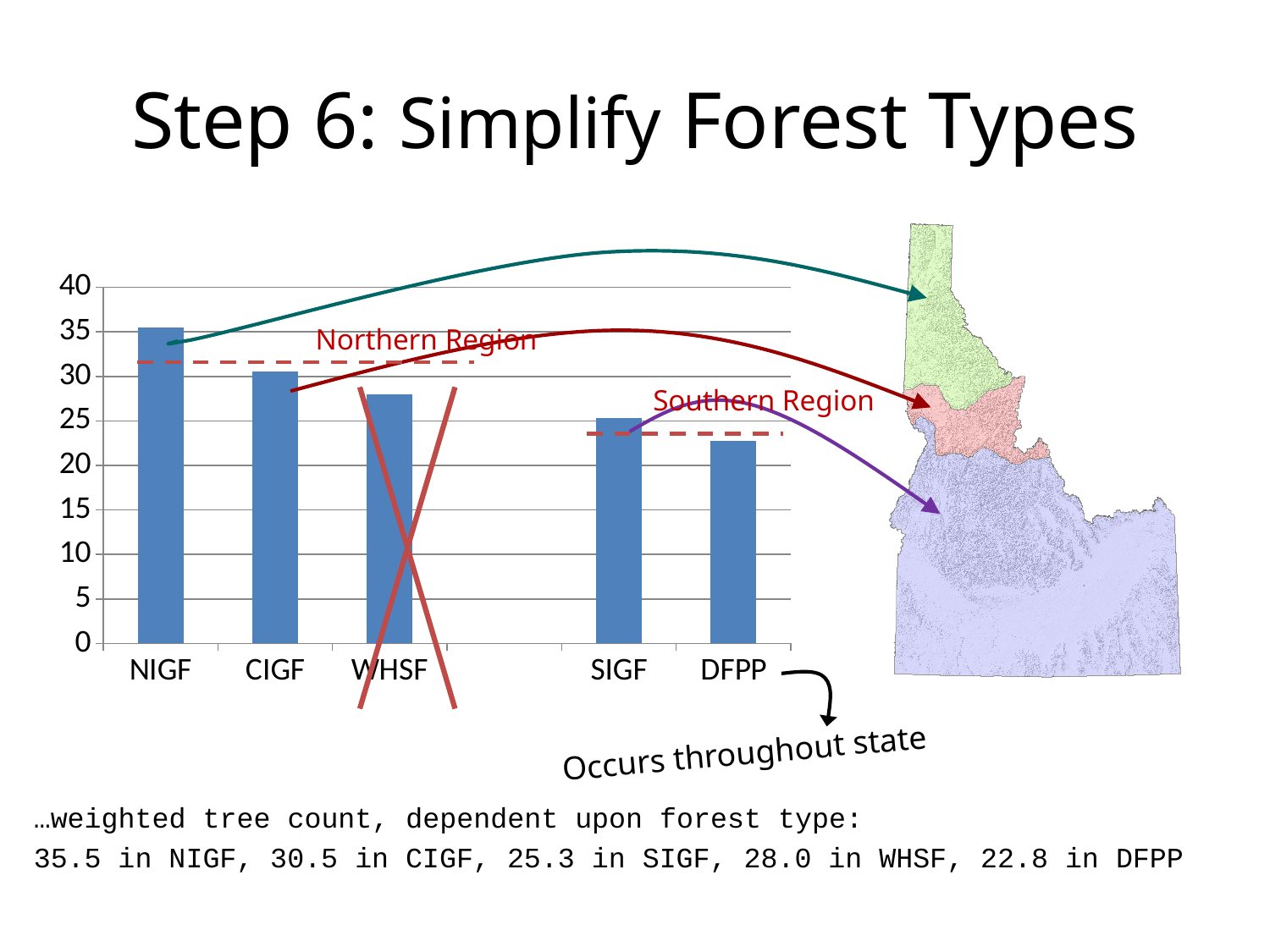
What is the weighted tree count for WHSF? 28.0 What kind of chart is shown on the slide? bar chart What is the difference between the weighted tree counts for NIGF and CIGF? 5.0 Do the bar values rise or fall from left to right across the chart? fall Which forest type has the highest bar in the chart? NIGF Is the value for DFPP greater or less than 25? less Which forest type has the lowest bar in the chart? DFPP What is the weighted tree count for NIGF? 35.5 Which has a larger weighted tree count, CIGF or SIGF? CIGF What is the weighted tree count for DFPP? 22.8 How many forest type categories are plotted in the bar chart? 5 Which forest type's bar is crossed out with a red X on the chart? WHSF